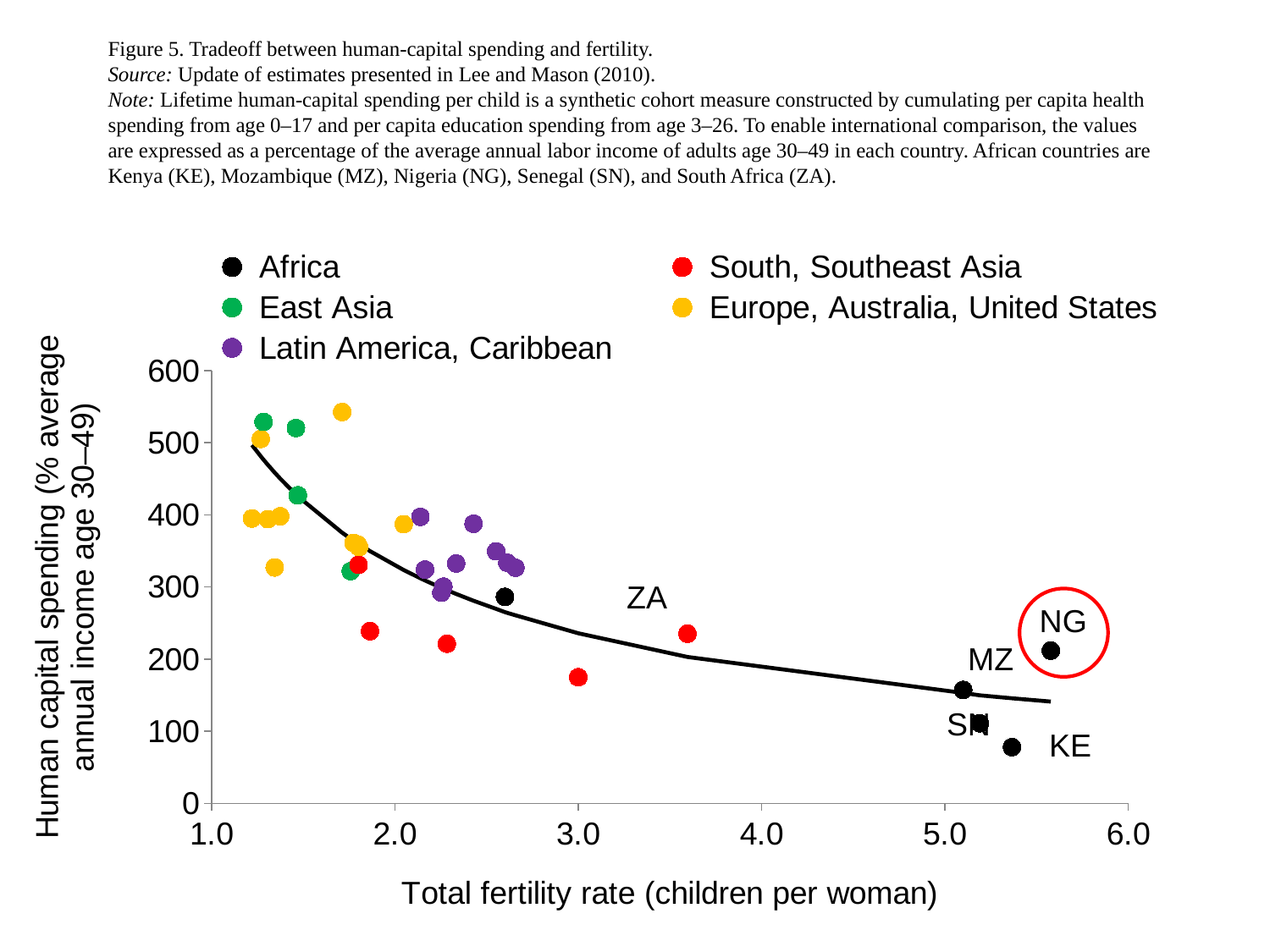
Does human capital spending generally rise or fall as the total fertility rate increases? fall Among the labeled African countries, which has the highest human capital spending? ZA Is the human capital spending value for MZ greater or less than 200? less Among the labeled African countries, which has the lowest human capital spending? KE Is the human capital spending value for NG greater or less than 200? greater Which country's point is circled in red on the chart? NG Is the total fertility rate for ZA greater or less than 4.0? less Which has the higher human capital spending, KE or NG? NG How many series does the legend list? 5 What kind of chart is shown on the slide? scatter chart